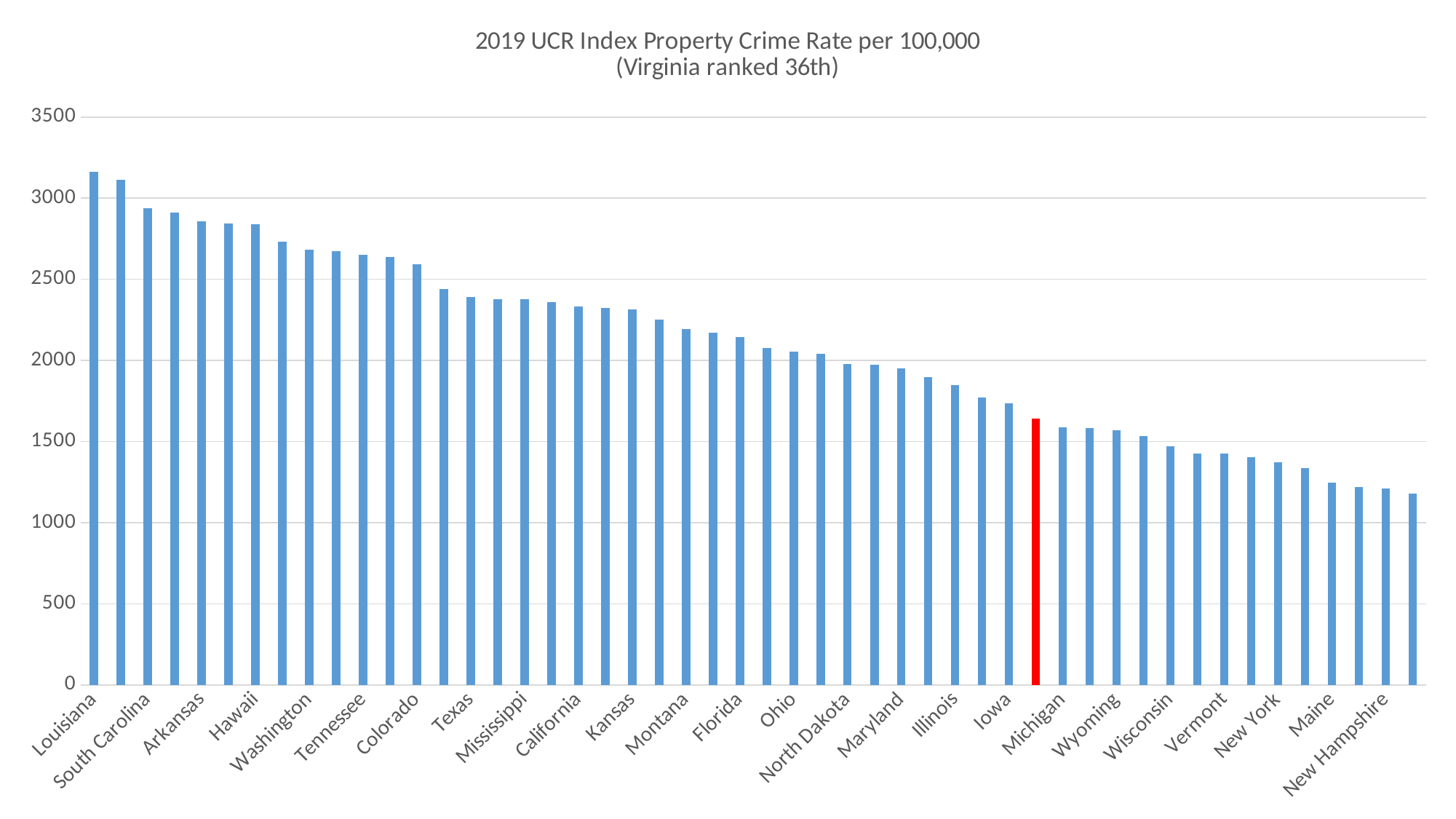
Which has the larger value, Maine or Hawaii? Hawaii What kind of chart is shown on the slide? bar chart Is the value for Iowa greater or less than 1500? greater Do the values rise or fall moving from left to right along the x axis? fall Is the value for Texas greater or less than 2000? greater What is the title of the chart? 2019 UCR Index Property Crime Rate per 100,000 (Virginia ranked 36th) Is the value for Louisiana greater or less than 3000? greater Which has the larger value, Texas or Florida? Texas Which state does the red bar represent? Virginia Which state has the highest property crime rate in the chart? Louisiana